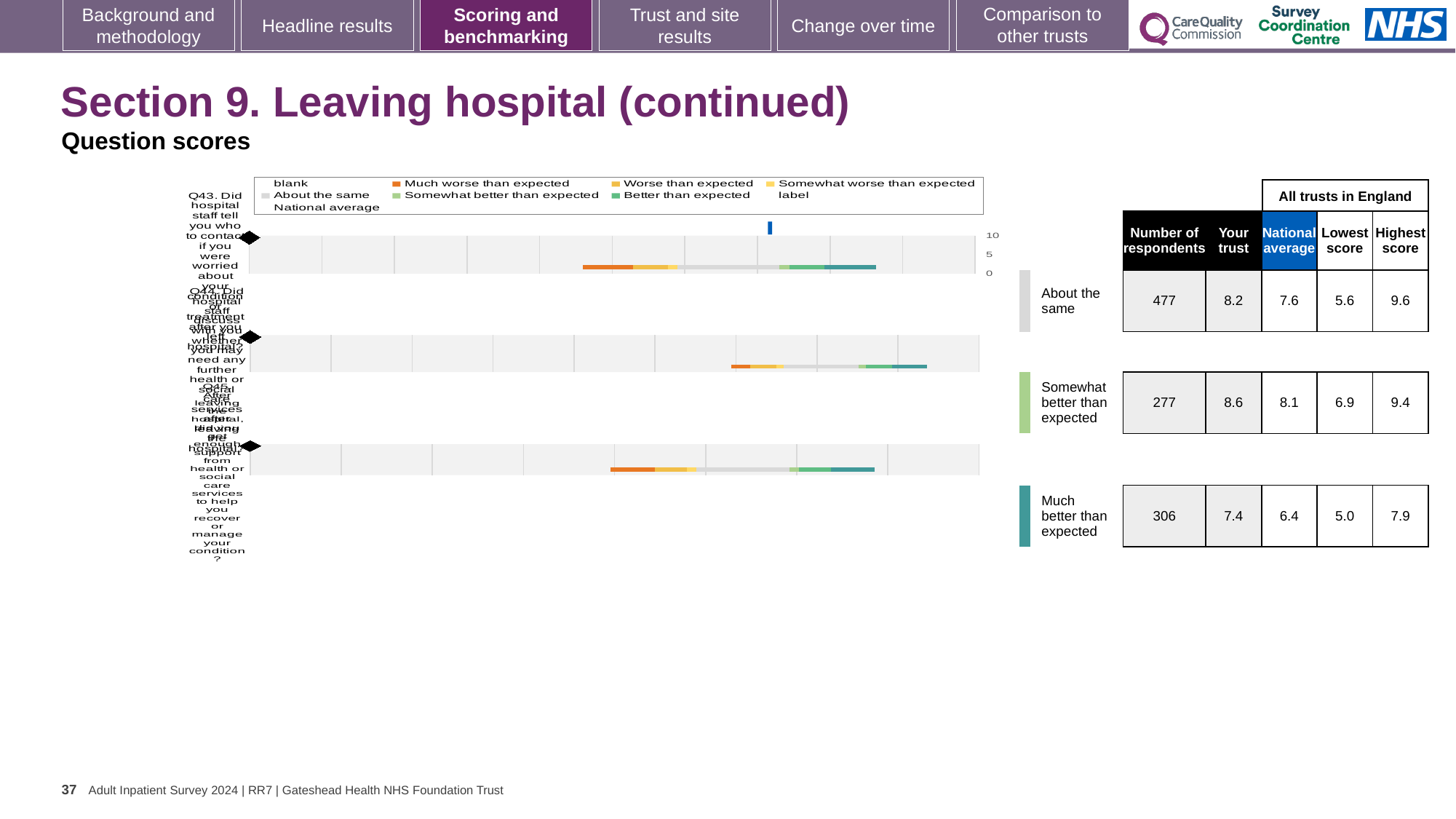
What is the 'Your trust' score for Q43 (Did hospital staff tell you who to contact if you were worried about your condition or treatment after you left hospital?)? 8.2 How many questions (bars) are plotted in the question scores chart? 3 For Q43, which is larger: the 'Your trust' score or the national average? Your trust Which of the three questions has the highest 'Your trust' score? Q44 Which of the three questions has the lowest number of respondents? Q44 Which colour does the legend use for 'Much worse than expected'? orange What is the highest value shown on the chart's score axis? 10 What is the national average score for Q45 (After leaving hospital, did you get enough support from health or social care services to help you recover or manage your condition?)? 6.4 What is the difference between the 'Your trust' score and the national average for Q44? 0.5 How many respondents answered Q44 (Did hospital staff discuss with you whether you may need any further health or social care services after leaving hospital?)? 277 What kind of chart is used to show the question scores on this slide? bar chart What benchmark category is Q45 placed in? Much better than expected